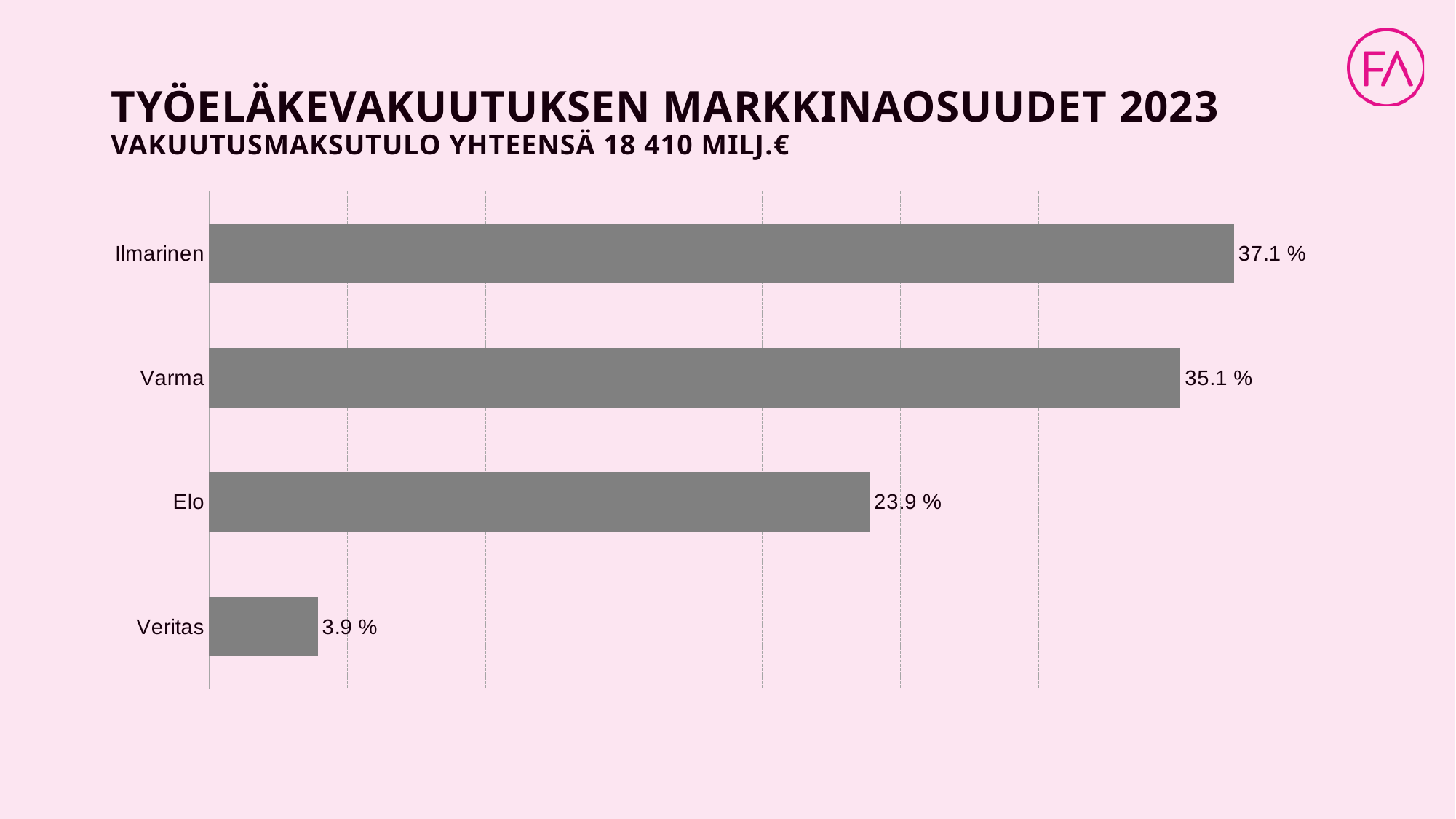
What is the market share shown for Elo? 23.9 % What is the difference in market share between Elo and Veritas? 20.0 % What is the title of the chart on the slide? TYÖELÄKEVAKUUTUKSEN MARKKINAOSUUDET 2023 How many companies are shown in the chart? 4 Which company has the highest market share? Ilmarinen What is the market share shown for Varma? 35.1 % Which has a larger market share, Varma or Elo? Varma Which company has the lowest market share? Veritas What type of chart is shown on the slide? Bar chart What is the difference in market share between Ilmarinen and Varma? 2.0 % What is the market share shown for Veritas? 3.9 % What is the market share shown for Ilmarinen? 37.1 %